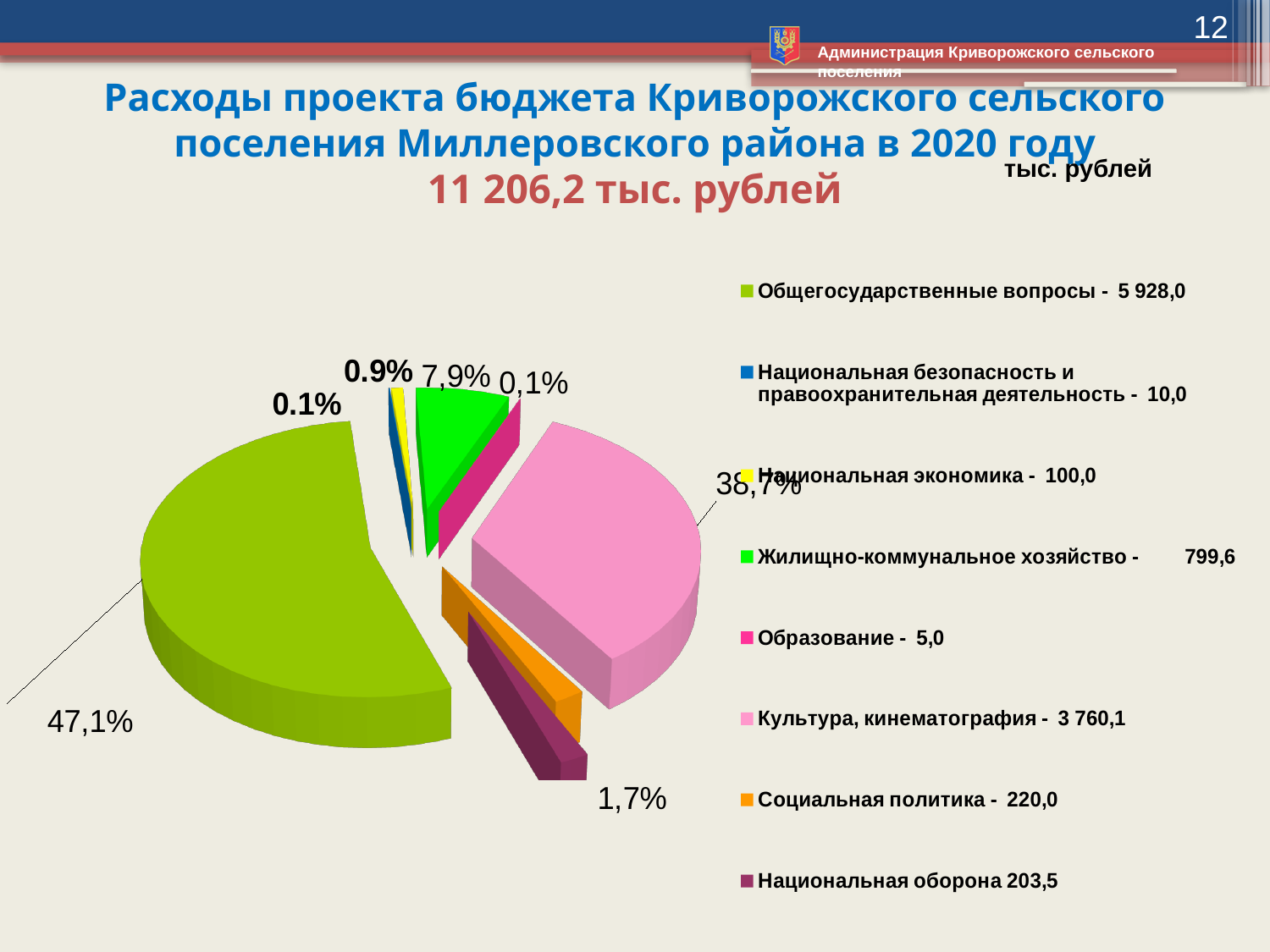
What is the value shown in the legend for Национальная оборона? 203,5 How many categories does the legend of the pie chart list? 8 What is the difference between the values for Общегосударственные вопросы and Культура, кинематография? 2 167,9 What is the value shown in the legend for Общегосударственные вопросы? 5 928,0 What is the value shown in the legend for Культура, кинематография? 3 760,1 What share of the pie does Общегосударственные вопросы represent? 47,1% Which category has the largest value in the pie chart? Общегосударственные вопросы Which is larger: the value for Социальная политика or the value for Национальная оборона? Социальная политика What kind of chart is shown on the slide? pie chart What total amount in тыс. рублей is stated in the chart title? 11 206,2 тыс. рублей Which category has the smallest value in the pie chart? Образование What is the value shown in the legend for Жилищно-коммунальное хозяйство? 799,6